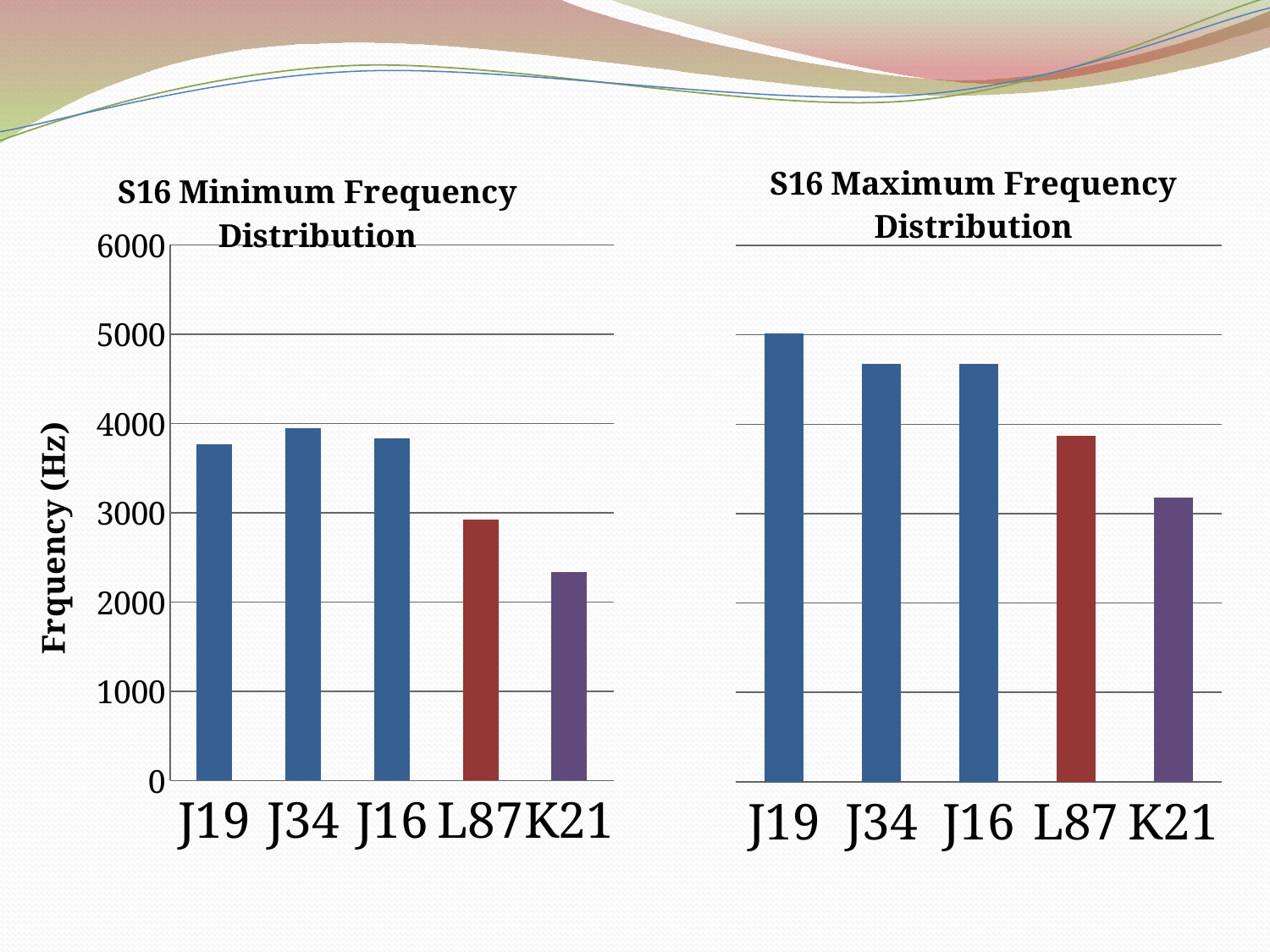
In the S16 Maximum Frequency Distribution chart, is the value for J34 greater or less than 4000? greater In the S16 Maximum Frequency Distribution chart, which is larger, the value for L87 or the value for K21? L87 How many categories are shown on the x axis of the S16 Maximum Frequency Distribution chart? 5 What kind of chart is the S16 Minimum Frequency Distribution chart? bar chart In the S16 Minimum Frequency Distribution chart, which category has the lowest value? K21 In the S16 Maximum Frequency Distribution chart, is the value for K21 greater or less than 4000? less In the S16 Minimum Frequency Distribution chart, is the value for J34 greater or less than 3000? greater In the S16 Maximum Frequency Distribution chart, which category has the highest value? J19 What is the label on the y axis of the S16 Minimum Frequency Distribution chart? Frquency (Hz) In the S16 Maximum Frequency Distribution chart, which category has the lowest value? K21 In the S16 Minimum Frequency Distribution chart, which is larger, the value for J19 or the value for K21? J19